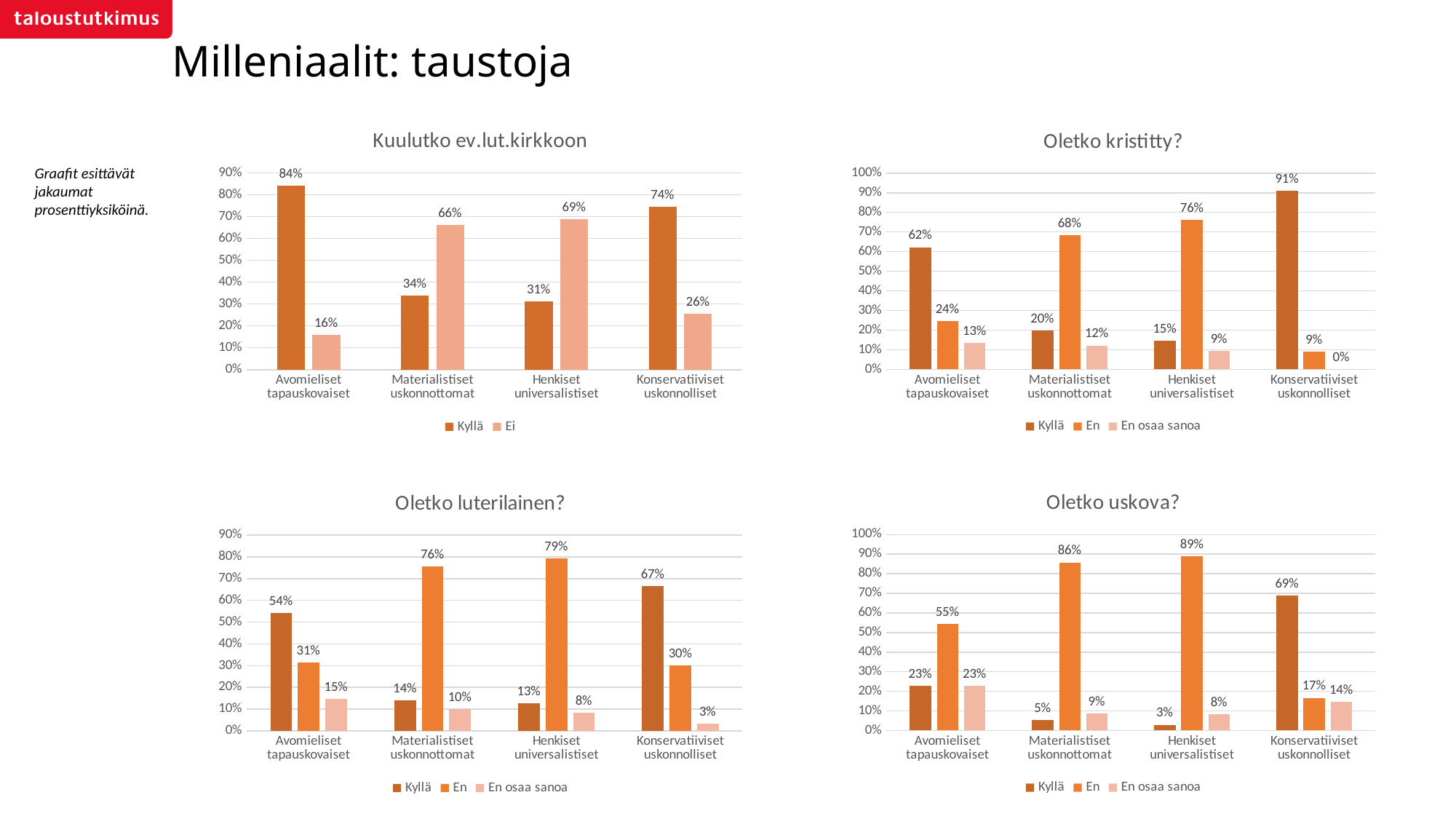
In the 'Kuulutko ev.lut.kirkkoon' chart, which category has the highest Ei value? Henkiset universalistiset What kind of chart is the 'Oletko uskova?' chart? Bar chart In the 'Oletko kristitty?' chart, which category has the lowest En osaa sanoa value? Konservatiiviset uskonnolliset In the 'Kuulutko ev.lut.kirkkoon' chart, what is the difference between the Kyllä and Ei values for Konservatiiviset uskonnolliset? 48% In the 'Oletko kristitty?' chart, what is the Kyllä value for Konservatiiviset uskonnolliset? 91% In the 'Oletko luterilainen?' chart, what is the En value for Henkiset universalistiset? 79% In the 'Oletko luterilainen?' chart, which is larger for Avomieliset tapauskovaiset: Kyllä or En? Kyllä In the 'Kuulutko ev.lut.kirkkoon' chart, what is the Kyllä value for Avomieliset tapauskovaiset? 84% In the 'Oletko uskova?' chart, what is the Kyllä value for Henkiset universalistiset? 3% In the 'Oletko uskova?' chart, which category has the highest En value? Henkiset universalistiset In the 'Oletko kristitty?' chart, how many series does the legend list? 3 In the 'Oletko luterilainen?' chart, how many categories are shown on the x axis? 4